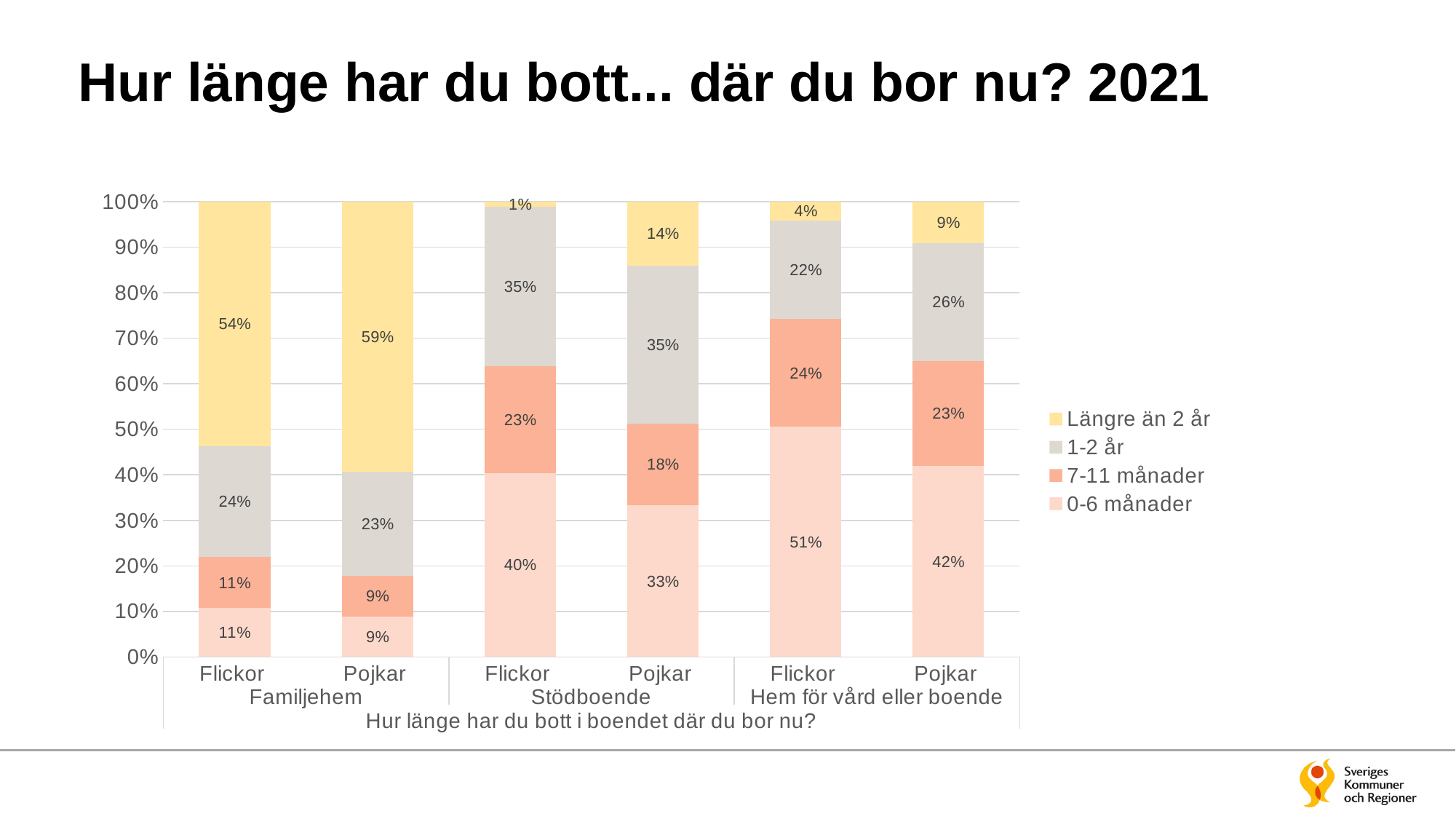
Which bar has the highest value for Längre än 2 år? Pojkar, Familjehem What is the value for 1-2 år for Pojkar in Stödboende? 35% How many series does the legend list? 4 What percentage of Flickor in Familjehem have lived there longer than 2 years (Längre än 2 år)? 54% What is the value for 0-6 månader for Pojkar in Hem för vård eller boende? 42% What kind of chart is shown on the slide? Stacked bar chart Which bar has the lowest value for Längre än 2 år? Flickor, Stödboende What is the difference between the 0-6 månader values for Flickor and Pojkar in Stödboende? 7 percentage points How many bars are shown in the chart? 6 What is the value for 7-11 månader for Flickor in Hem för vård eller boende? 24% Which colour represents the 0-6 månader series in the legend? Light pink Which is larger: the 1-2 år value for Flickor in Familjehem or for Pojkar in Familjehem? Flickor in Familjehem